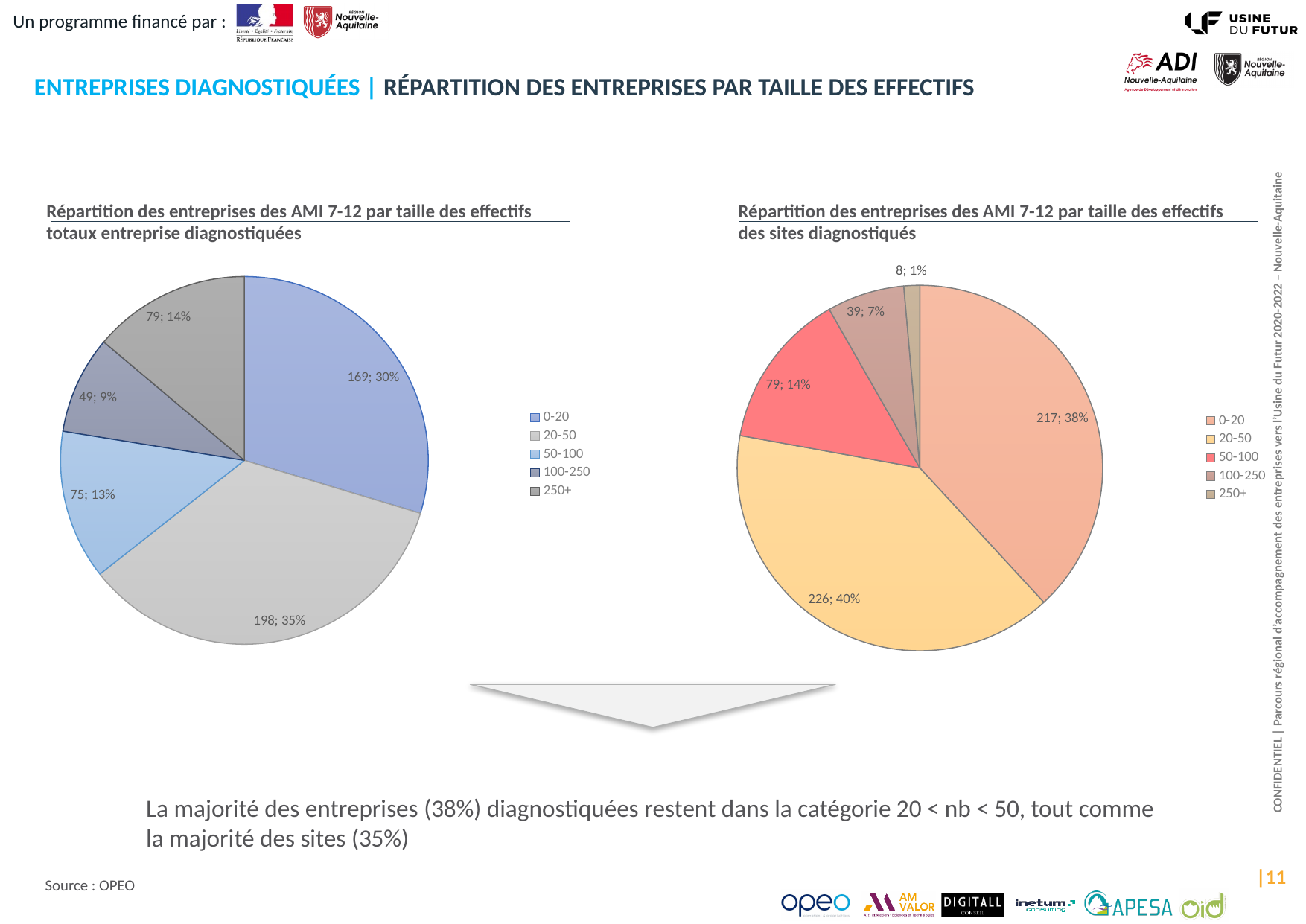
In the left pie chart (totaux entreprise diagnostiquées), which category has the largest slice? 20-50 In the left pie chart (totaux entreprise diagnostiquées), what is the value and share for the 20-50 category? 198; 35% What is the title of the left pie chart? Répartition des entreprises des AMI 7-12 par taille des effectifs totaux entreprise diagnostiquées In the left pie chart (totaux entreprise diagnostiquées), what is the difference between the 0-20 value and the 50-100 value? 94 How many categories does the legend of the right pie chart (sites diagnostiqués) list? 5 In the right pie chart (sites diagnostiqués), what is the value and share for the 250+ category? 8; 1% In the right pie chart (sites diagnostiqués), what share of the pie does the 20-50 slice represent? 40% In the right pie chart (sites diagnostiqués), which is larger: the 50-100 slice or the 100-250 slice? 50-100 What type of charts are shown on the slide? Pie charts In the right pie chart (sites diagnostiqués), which category has the smallest slice? 250+ In the right pie chart (sites diagnostiqués), what is the value and share for the 0-20 category? 217; 38% In the left pie chart (totaux entreprise diagnostiquées), what is the value and share for the 100-250 category? 49; 9%